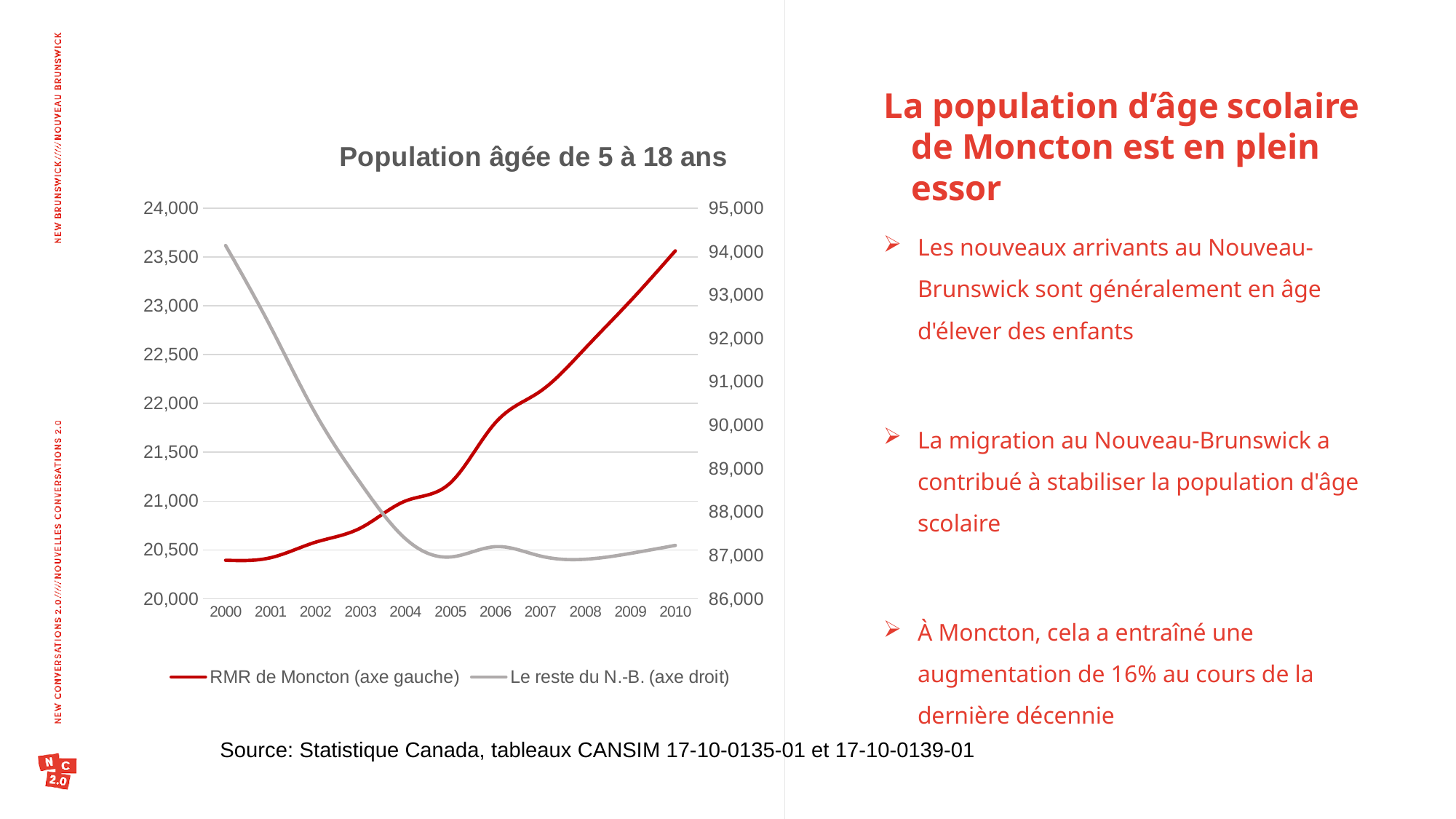
What kind of chart is shown on the slide? line chart Is the value for 'Le reste du N.-B.' in 2000 greater or less than 93,000? greater Does the value for 'Le reste du N.-B.' rise or fall from 2000 to 2005? fall Is the value for 'Le reste du N.-B.' in 2005 greater or less than 88,000? less What is the title of the chart? Population âgée de 5 à 18 ans How many series does the legend list? 2 Is the value for 'RMR de Moncton' in 2010 greater or less than 23,000? greater Does the value for 'RMR de Moncton' rise or fall from 2000 to 2010? rise Which axis does the series 'RMR de Moncton' use according to the legend? axe gauche In which year is the value for 'Le reste du N.-B.' highest? 2000 How many years are plotted along the x axis? 11